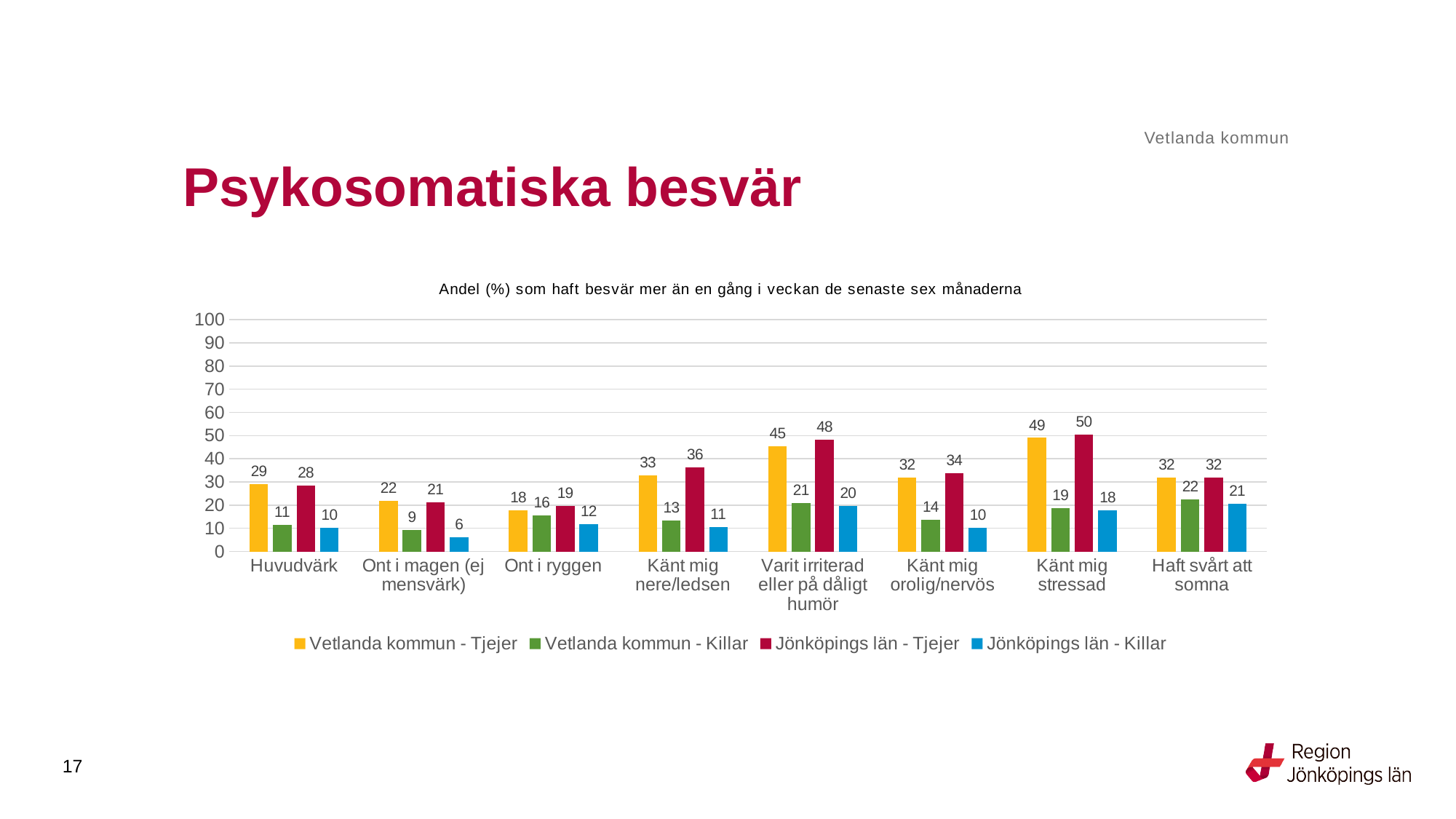
What is the value for Vetlanda kommun - Tjejer for Huvudvärk? 29 Which is larger for Känt mig nere/ledsen: Vetlanda kommun - Tjejer or Jönköpings län - Tjejer? Jönköpings län - Tjejer What kind of chart is shown on the slide? Bar chart What is the value for Vetlanda kommun - Killar for Haft svårt att somna? 22 Is the value for Jönköpings län - Tjejer for Varit irriterad eller på dåligt humör greater or less than 40? greater Which category has the lowest value for Vetlanda kommun - Tjejer? Ont i ryggen What is the difference between Vetlanda kommun - Tjejer and Vetlanda kommun - Killar for Känt mig stressad? 30 How many categories are shown on the x axis? 8 What is the title of the chart? Andel (%) som haft besvär mer än en gång i veckan de senaste sex månaderna What is the value for Jönköpings län - Killar for Ont i magen (ej mensvärk)? 6 Which category has the highest value for Jönköpings län - Tjejer? Känt mig stressad How many series does the legend list? 4